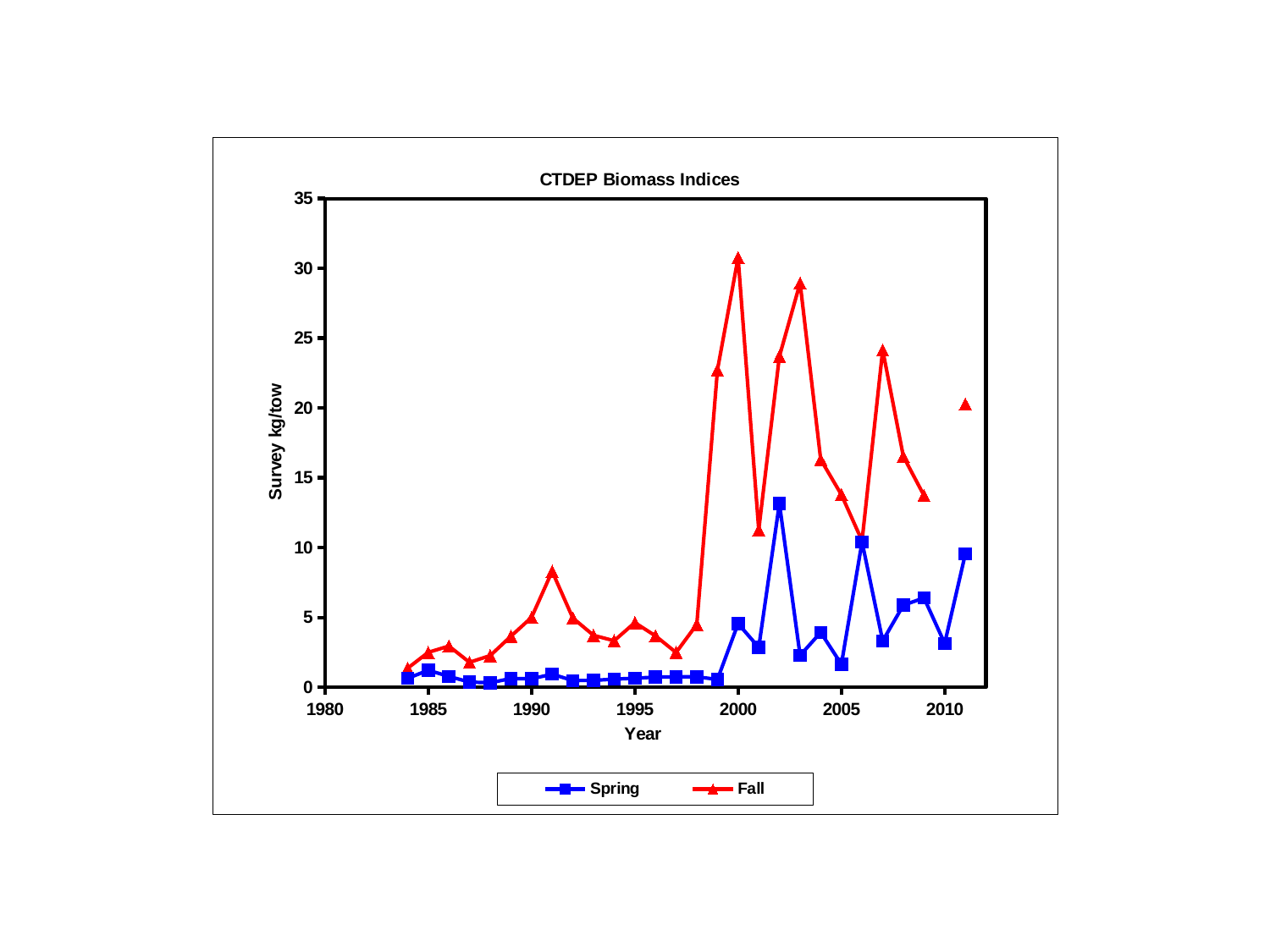
What is the title of the chart? CTDEP Biomass Indices How many series does the legend list? 2 What kind of chart is shown on the slide? line chart Does the Fall series rise or fall from 2007 to 2009? fall Is the Fall value for 2001 greater or less than 15? less Is the Spring value for 2002 greater or less than 10? greater In which year does the Spring series reach its highest value? 2002 Is the Fall value for 2000 greater or less than 25? greater In which year does the Fall series reach its highest value? 2000 In 2000, which series has the larger value, Spring or Fall? Fall What is the label of the y axis? Survey kg/tow